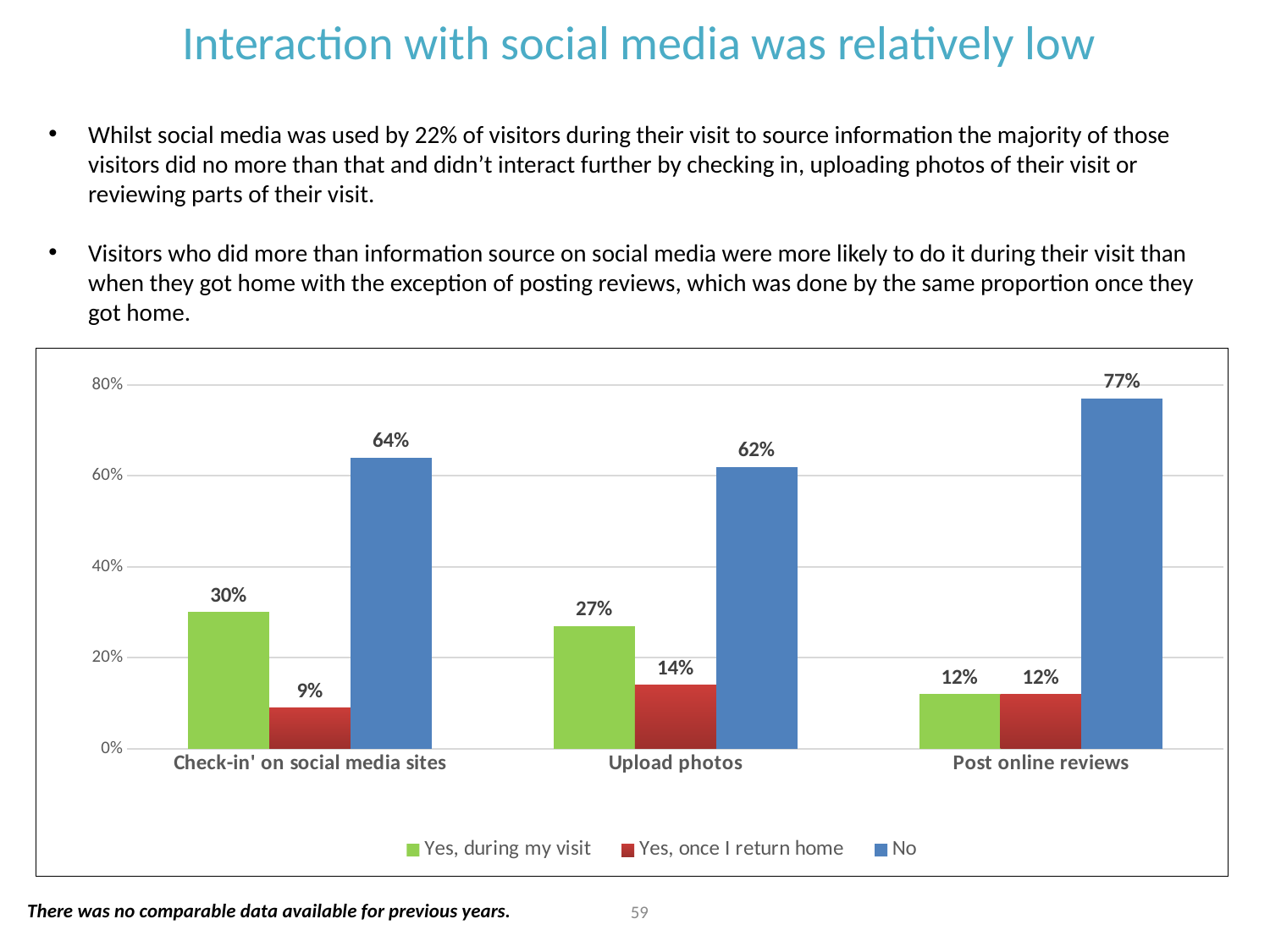
What percentage of visitors said 'Yes, during my visit' for 'Check-in' on social media sites'? 30% What kind of chart is shown on the slide? Bar chart What percentage said 'Yes, once I return home' for 'Upload photos'? 14% How many series does the legend list? 3 What colour represents the 'No' series in the chart? Blue Which category has the lowest 'Yes, once I return home' value? Check-in' on social media sites Which is larger: 'Yes, during my visit' for 'Check-in' on social media sites' or for 'Upload photos'? Check-in' on social media sites What is the difference between the 'No' values for 'Post online reviews' and 'Upload photos'? 15% What is the value for 'No' in the 'Post online reviews' category? 77% How many categories are shown on the x axis? 3 Does the 'No' value rise or fall from 'Upload photos' to 'Post online reviews'? Rise Which category has the highest 'No' value? Post online reviews